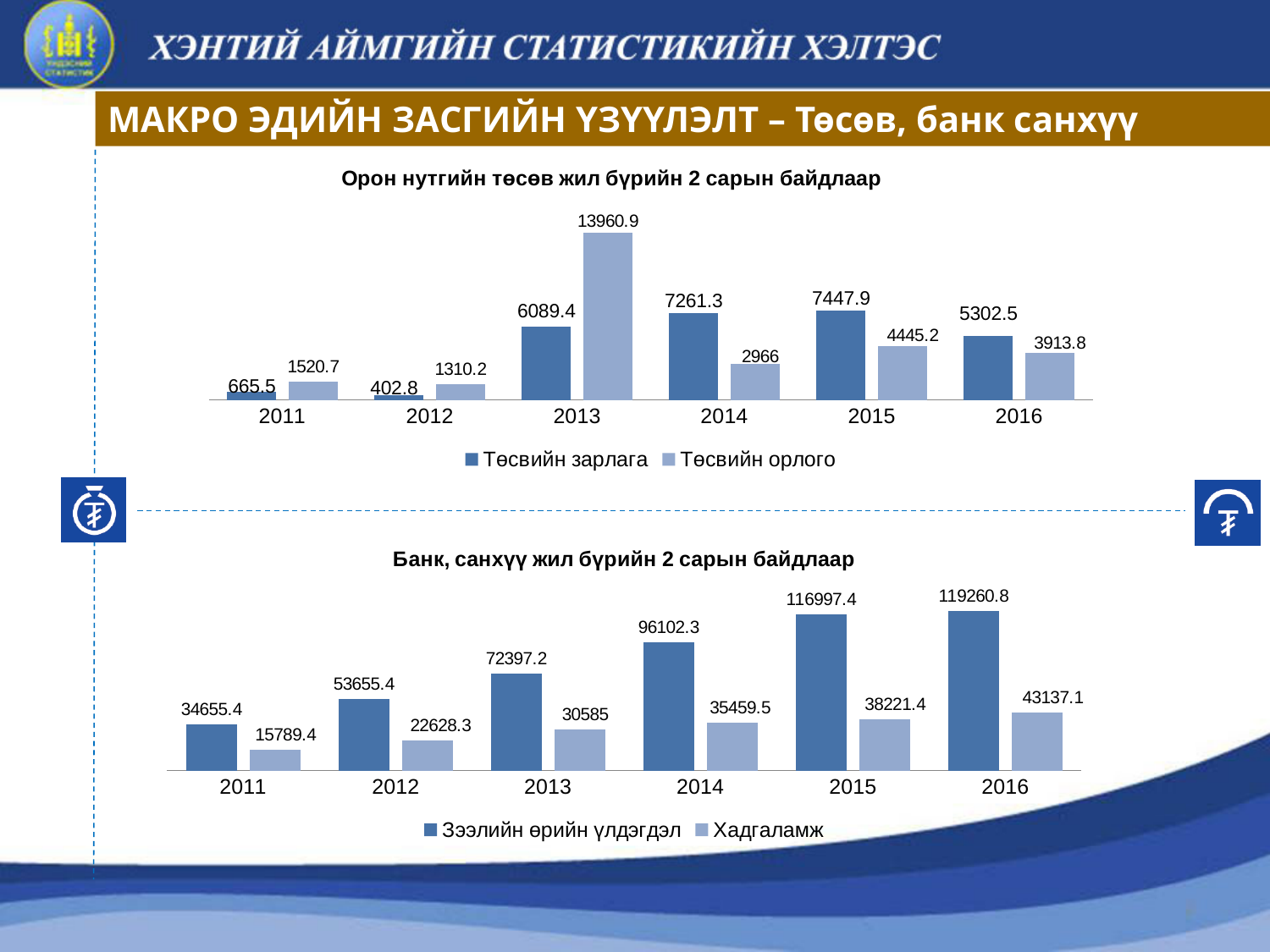
In the top chart (Орон нутгийн төсөв жил бүрийн 2 сарын байдлаар), what is the value of Төсвийн зарлага for 2015? 7447.9 In the bottom chart (Банк, санхүү жил бүрийн 2 сарын байдлаар), what is the value of Зээлийн өрийн үлдэгдэл for 2014? 96102.3 In the bottom chart (Банк, санхүү жил бүрийн 2 сарын байдлаар), which year has the highest Хадгаламж value? 2016 How many years are shown on the x axis of the bottom chart (Банк, санхүү жил бүрийн 2 сарын байдлаар)? 6 In the bottom chart (Банк, санхүү жил бүрийн 2 сарын байдлаар), what is the value of Хадгаламж for 2011? 15789.4 In the top chart (Орон нутгийн төсөв жил бүрийн 2 сарын байдлаар), which is larger in 2014: Төсвийн зарлага or Төсвийн орлого? Төсвийн зарлага In the top chart (Орон нутгийн төсөв жил бүрийн 2 сарын байдлаар), what is the value of Төсвийн орлого for 2013? 13960.9 In the top chart (Орон нутгийн төсөв жил бүрийн 2 сарын байдлаар), which year has the lowest Төсвийн зарлага value? 2012 In the bottom chart (Банк, санхүү жил бүрийн 2 сарын байдлаар), does Зээлийн өрийн үлдэгдэл rise or fall from 2011 to 2016? rise What kind of chart is the bottom chart (Банк, санхүү жил бүрийн 2 сарын байдлаар)? bar chart How many series does the legend of the top chart (Орон нутгийн төсөв жил бүрийн 2 сарын байдлаар) list? 2 In the top chart (Орон нутгийн төсөв жил бүрийн 2 сарын байдлаар), what is the difference between Төсвийн зарлага and Төсвийн орлого in 2016? 1388.7